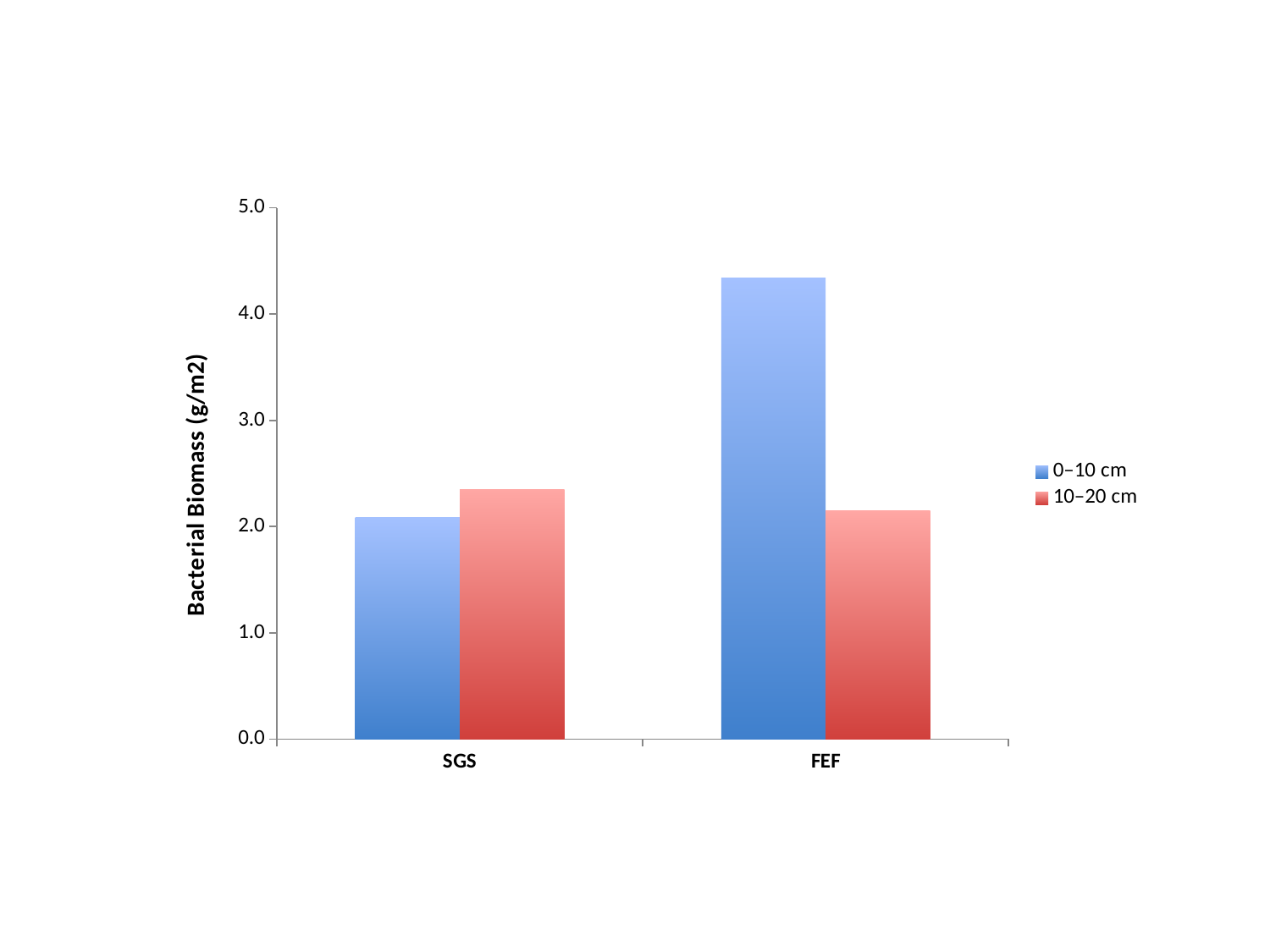
Is the value for SGS in the 0–10 cm series greater or less than 3.0? less Is the value for FEF in the 10–20 cm series greater or less than 3.0? less Which category and series has the highest bacterial biomass? FEF, 0–10 cm Is the value for SGS in the 10–20 cm series greater or less than 2.0? greater What is the label of the y axis? Bacterial Biomass (g/m2) What kind of chart is shown on the slide? bar chart For FEF, which is larger: the 0–10 cm bar or the 10–20 cm bar? 0–10 cm How many series does the legend list? 2 For SGS, which is larger: the 0–10 cm bar or the 10–20 cm bar? 10–20 cm Which colour represents the 10–20 cm series in the legend? red How many categories are shown on the x axis? 2